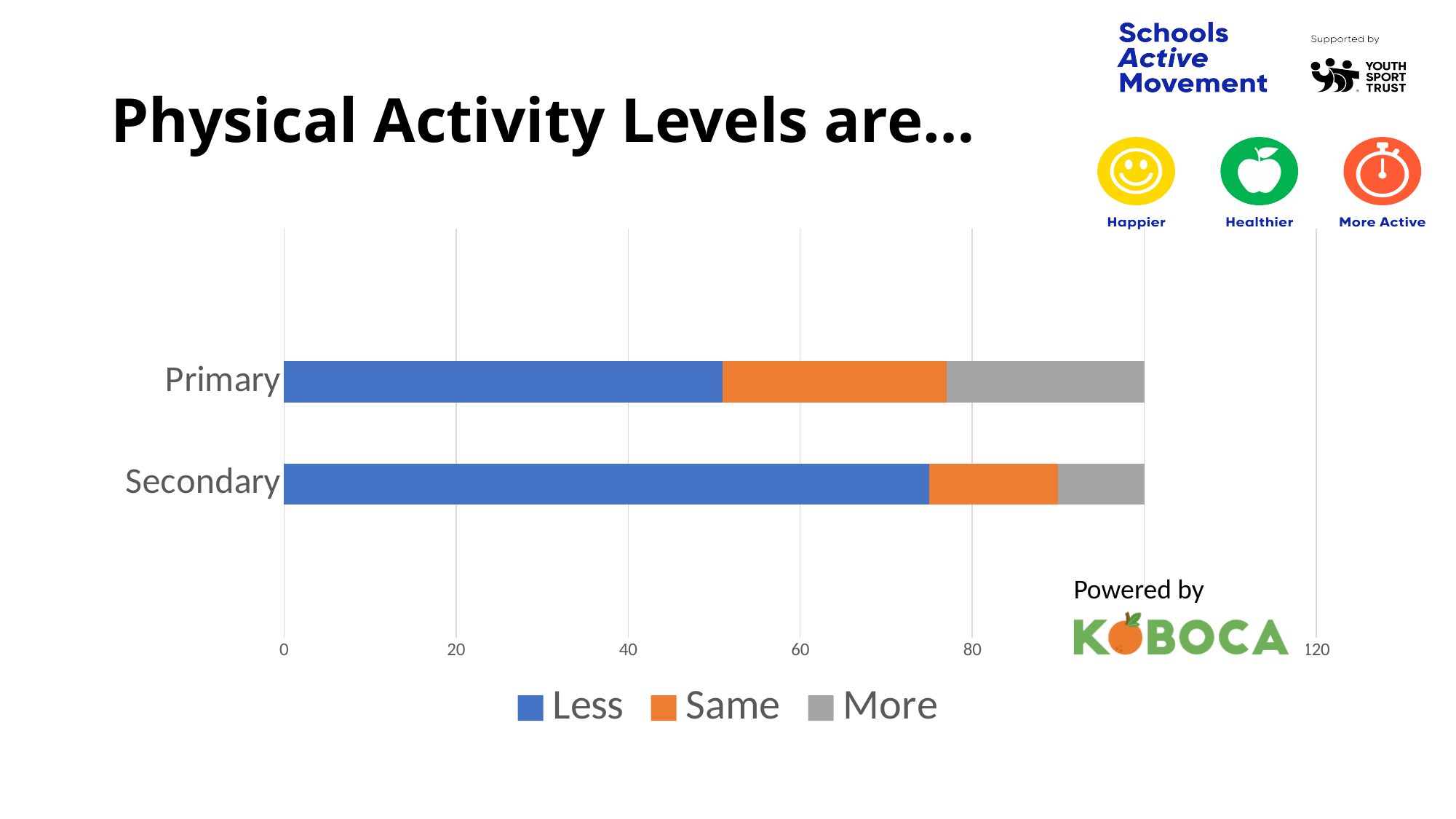
Which series is shown in blue in the chart? Less Is the value for Less in the Primary bar greater or less than 60? less Which category has the larger Same value, Primary or Secondary? Primary What kind of chart is shown on the slide? bar chart How many series does the chart legend list? 3 Is the value for Less in the Secondary bar greater or less than 80? less How many categories are plotted on the chart? 2 Which category has the larger More value, Primary or Secondary? Primary Is the value for Less in the Primary bar greater or less than 40? greater Which category has the larger Less value, Primary or Secondary? Secondary What is the title of the chart on the slide? Physical Activity Levels are…